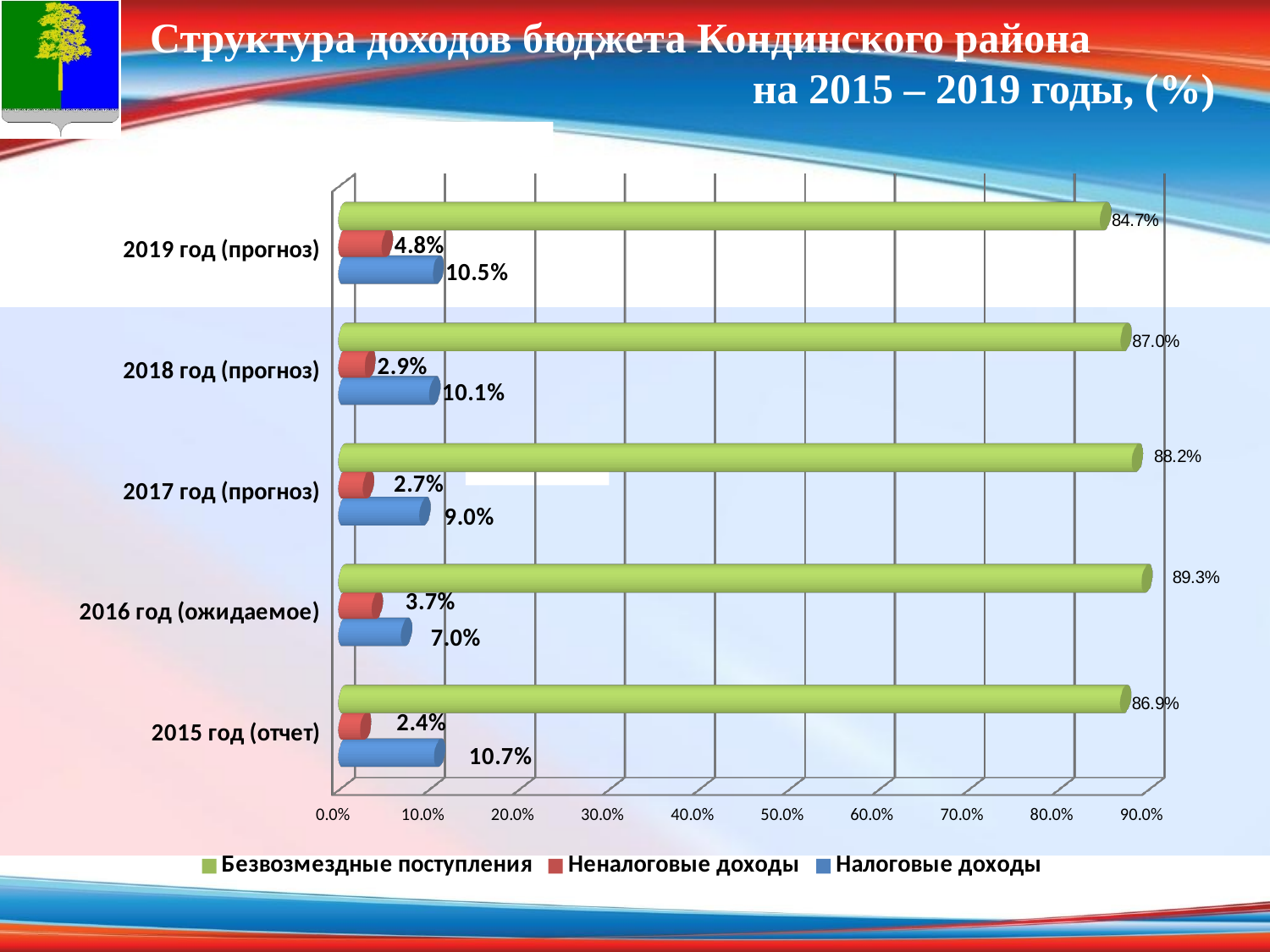
How many year categories are shown on the chart? 5 What is the value of Налоговые доходы for 2017 год (прогноз)? 9.0% Which colour represents Налоговые доходы in the chart? Blue In which year is Неналоговые доходы the lowest? 2015 год (отчет) Which is larger: Неналоговые доходы for 2018 год (прогноз) or for 2019 год (прогноз)? 2019 год (прогноз) What is the value of Безвозмездные поступления for 2019 год (прогноз)? 84.7% What is the value of Налоговые доходы for 2015 год (отчет)? 10.7% In which year is Безвозмездные поступления the highest? 2016 год (ожидаемое) What is the difference between Налоговые доходы for 2019 год (прогноз) and 2016 год (ожидаемое)? 3.5% How many series does the legend list? 3 What kind of chart is shown on the slide? Bar chart What is the value of Неналоговые доходы for 2016 год (ожидаемое)? 3.7%